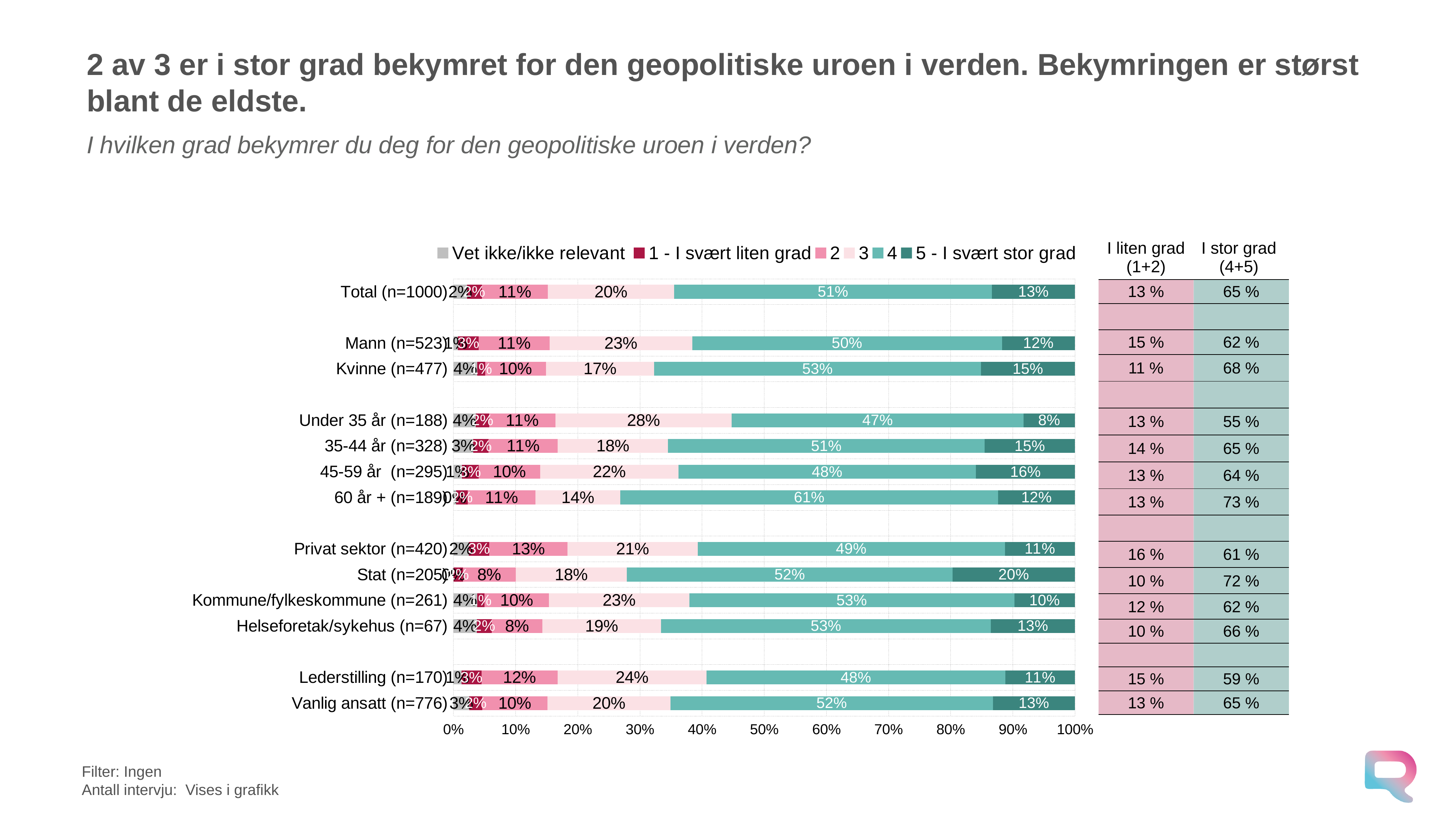
What kind of chart is shown on the slide? stacked bar chart What is the value of the '3' series for 'Under 35 år (n=188)'? 28% Which category has the lowest value for the '5 - I svært stor grad' series? Under 35 år (n=188) How many categories (rows) are plotted in the chart? 13 What is the combined '4' and '5' share (I stor grad) for '60 år + (n=189)' shown in the table beside the chart? 73 % Which is larger: the '2' series value for 'Privat sektor (n=420)' or for 'Stat (n=205)'? Privat sektor (n=420) What is the first entry in the chart legend? Vet ikke/ikke relevant Which category has the highest value for the '4' series? 60 år + (n=189) How many series does the legend list? 6 What is the difference between the '4' series values for 'Kvinne (n=477)' and 'Mann (n=523)'? 3% What is the value of the '5 - I svært stor grad' series for 'Stat (n=205)'? 20% What is the value of the '4' series for 'Total (n=1000)'? 51%